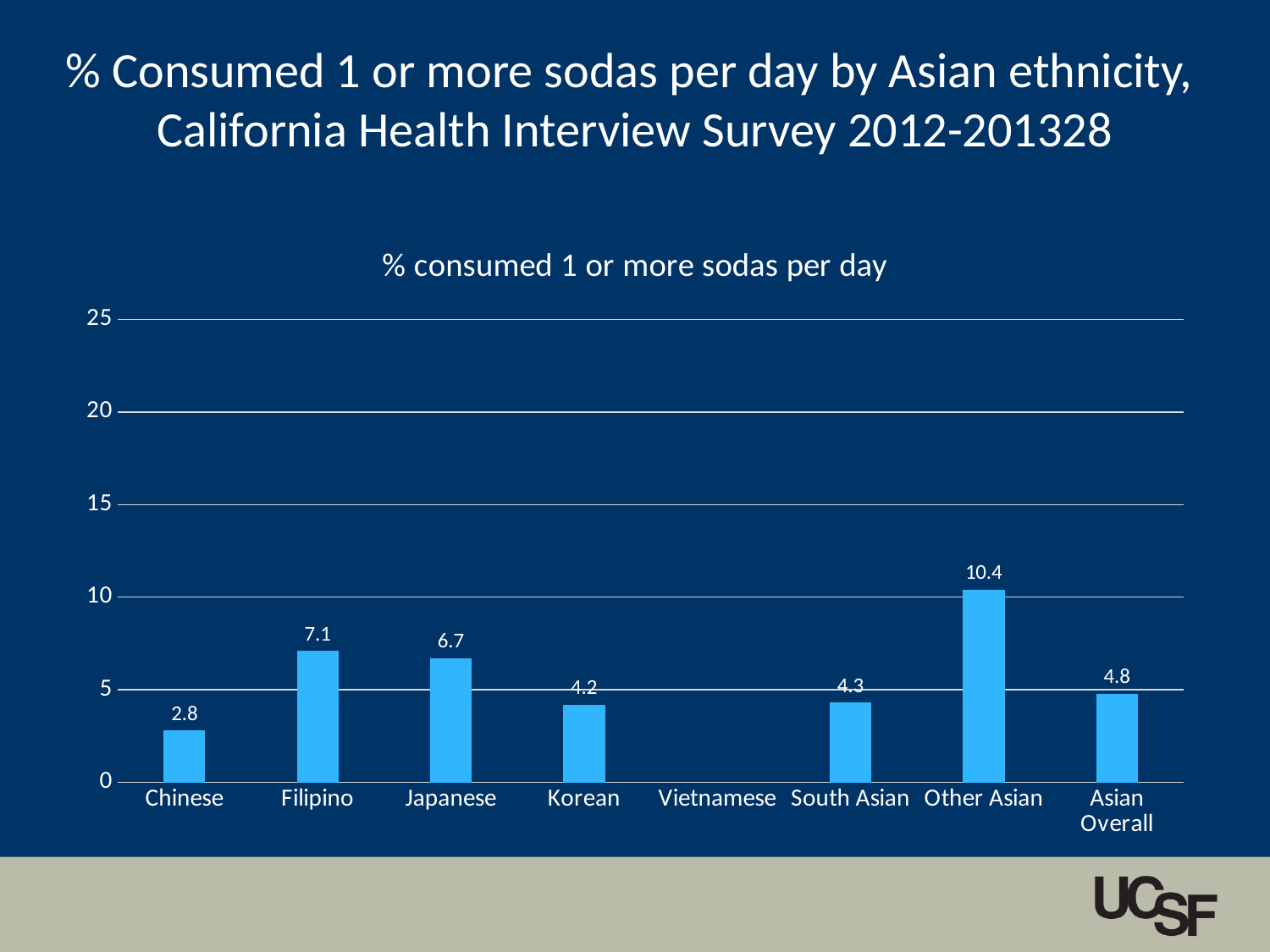
Which is larger, the value for Filipino or the value for Korean? Filipino Which category has the highest value? Other Asian What is the value for Asian Overall? 4.8 What is the value for Chinese? 2.8 Which category on the x axis has no bar shown? Vietnamese What is the difference between the values for Other Asian and Chinese? 7.6 Among the categories with a bar shown, which has the lowest value? Chinese What is the difference between the values for Filipino and Japanese? 0.4 What kind of chart is shown? bar chart How many categories are listed on the x axis? 8 Is the value for Other Asian greater or less than 10? greater What is the value for Other Asian? 10.4